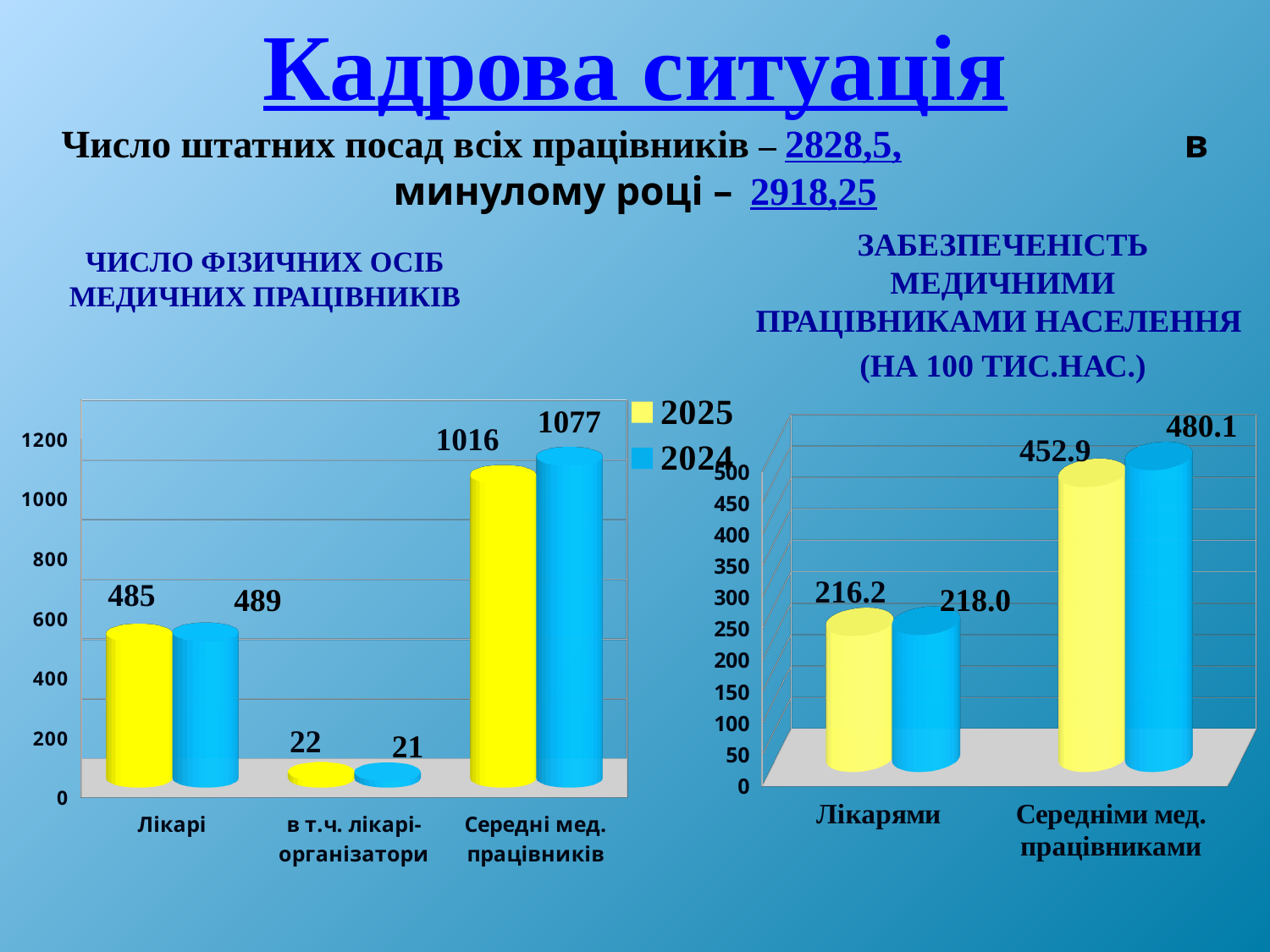
In the left chart (ЧИСЛО ФІЗИЧНИХ ОСІБ МЕДИЧНИХ ПРАЦІВНИКІВ), what is the 2024 value for Середні мед. працівників? 1077 In the right chart (ЗАБЕЗПЕЧЕНІСТЬ МЕДИЧНИМИ ПРАЦІВНИКАМИ НАСЕЛЕННЯ), what is the 2025 value for Лікарями? 216.2 What kind of chart is the left chart (ЧИСЛО ФІЗИЧНИХ ОСІБ МЕДИЧНИХ ПРАЦІВНИКІВ)? Bar chart In the left chart (ЧИСЛО ФІЗИЧНИХ ОСІБ МЕДИЧНИХ ПРАЦІВНИКІВ), how many categories are shown on the x axis? 3 In the right chart (ЗАБЕЗПЕЧЕНІСТЬ МЕДИЧНИМИ ПРАЦІВНИКАМИ НАСЕЛЕННЯ), which is larger for Середніми мед. працівниками: the 2025 value or the 2024 value? 2024 In the left chart (ЧИСЛО ФІЗИЧНИХ ОСІБ МЕДИЧНИХ ПРАЦІВНИКІВ), what is the difference between the 2024 and 2025 values for Середні мед. працівників? 61 In the right chart (ЗАБЕЗПЕЧЕНІСТЬ МЕДИЧНИМИ ПРАЦІВНИКАМИ НАСЕЛЕННЯ), what is the 2024 value for Середніми мед. працівниками? 480.1 In the left chart (ЧИСЛО ФІЗИЧНИХ ОСІБ МЕДИЧНИХ ПРАЦІВНИКІВ), what is the 2025 value for в т.ч. лікарі-організатори? 22 In the left chart (ЧИСЛО ФІЗИЧНИХ ОСІБ МЕДИЧНИХ ПРАЦІВНИКІВ), which category has the highest values? Середні мед. працівників In the right chart (ЗАБЕЗПЕЧЕНІСТЬ МЕДИЧНИМИ ПРАЦІВНИКАМИ НАСЕЛЕННЯ), what is the difference between the 2024 and 2025 values for Середніми мед. працівниками? 27.2 In the left chart (ЧИСЛО ФІЗИЧНИХ ОСІБ МЕДИЧНИХ ПРАЦІВНИКІВ), what is the 2025 value for Лікарі? 485 How many series does the legend list? 2